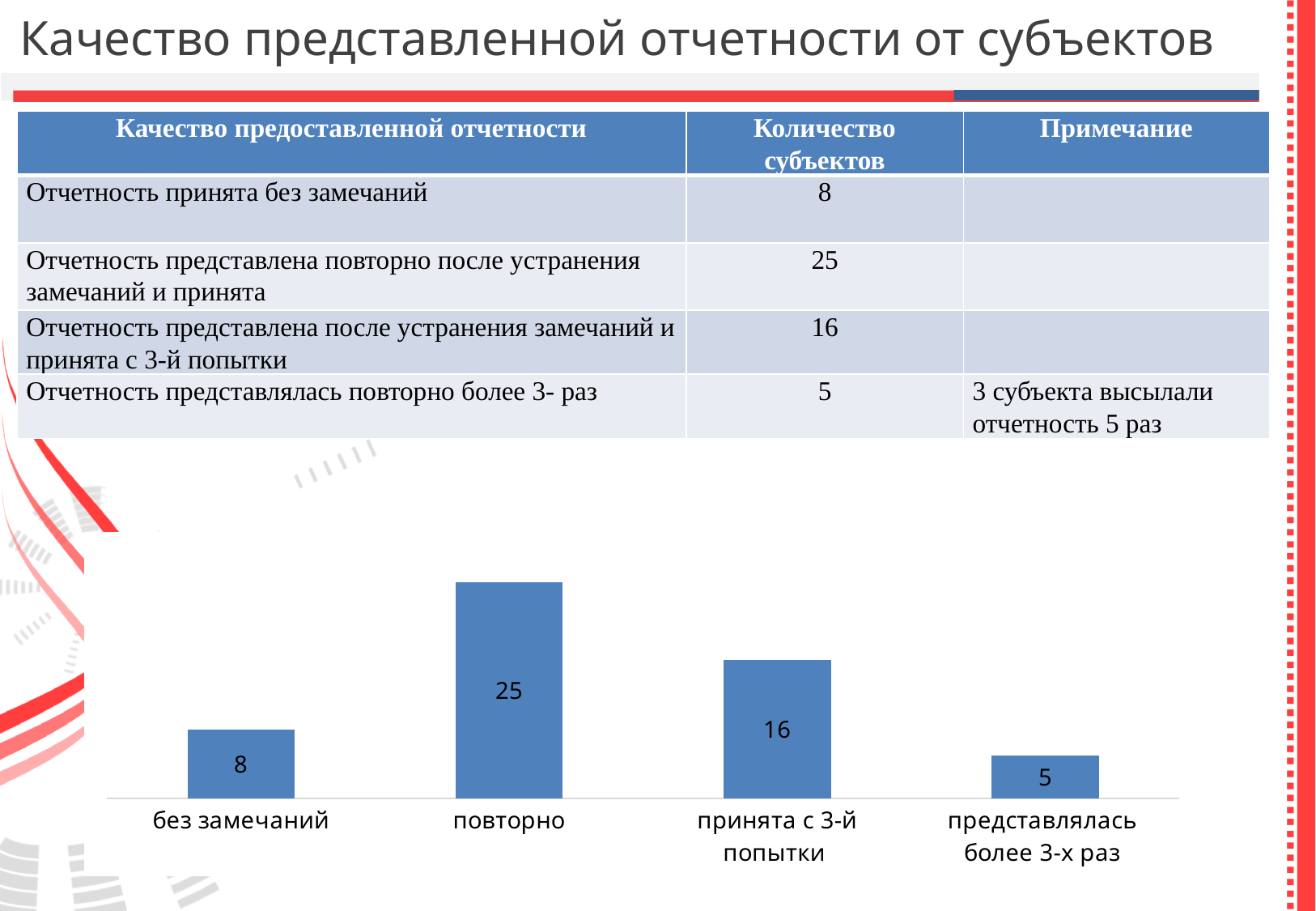
What is the value of the bar labelled "представлялась более 3-х раз"? 5 What is the value of the bar labelled "повторно"? 25 What is the difference between the values for "без замечаний" and "представлялась более 3-х раз"? 3 What is the total of all four bar values on the chart? 54 What is the value of the bar labelled "без замечаний"? 8 Which category has the lowest bar? представлялась более 3-х раз What is the difference between the values for "повторно" and "принята с 3-й попытки"? 9 How many categories are shown on the chart? 4 What kind of chart is shown on the slide? bar chart Which category has the highest bar? повторно What is the value of the bar labelled "принята с 3-й попытки"? 16 Which is larger, the value for "без замечаний" or the value for "принята с 3-й попытки"? принята с 3-й попытки